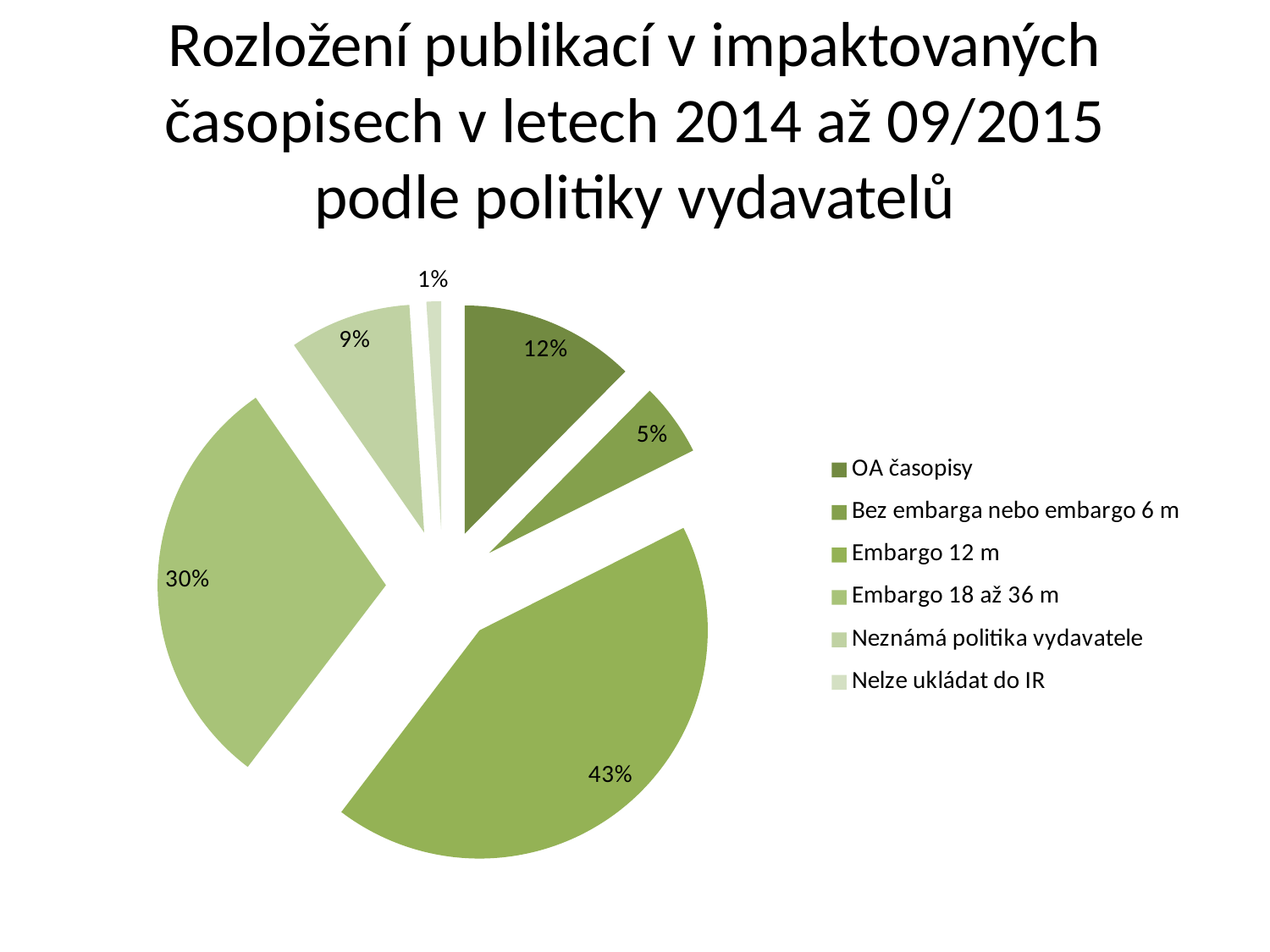
Which category has the largest share of the pie? Embargo 12 m What share of the pie does Neznámá politika vydavatele have? 9% How many categories does the legend list? 6 Which category has the smallest share of the pie? Nelze ukládat do IR Which has a larger share, OA časopisy or Neznámá politika vydavatele? OA časopisy What share of the pie does OA časopisy have? 12% What share of the pie does Embargo 12 m have? 43% What kind of chart is shown on the slide? Pie chart What is the difference in percentage points between Embargo 12 m and Embargo 18 až 36 m? 13